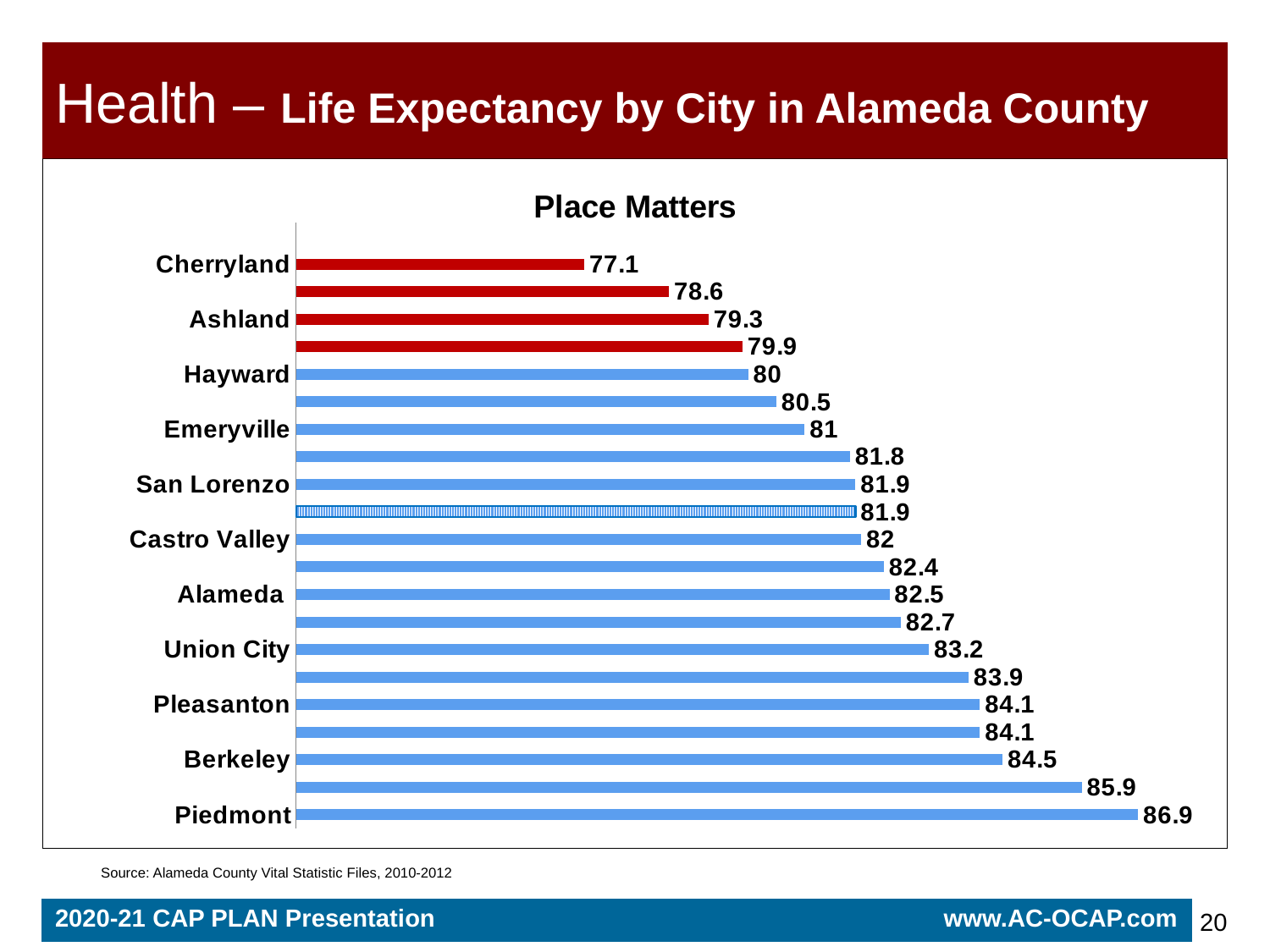
What is the life expectancy value shown for Piedmont? 86.9 Which has a higher life expectancy value, Berkeley or Emeryville? Berkeley Which labeled city has the highest life expectancy? Piedmont What is the life expectancy value shown for Cherryland? 77.1 How many bars in the chart are colored red? 4 What is the life expectancy value shown for Hayward? 80 What is the title of the chart? Place Matters How many bars are plotted in the chart? 21 What is the life expectancy value shown for Union City? 83.2 What type of chart is shown on the slide? Bar chart Which labeled city has the lowest life expectancy? Cherryland What is the difference between the life expectancy values for Piedmont and Cherryland? 9.8